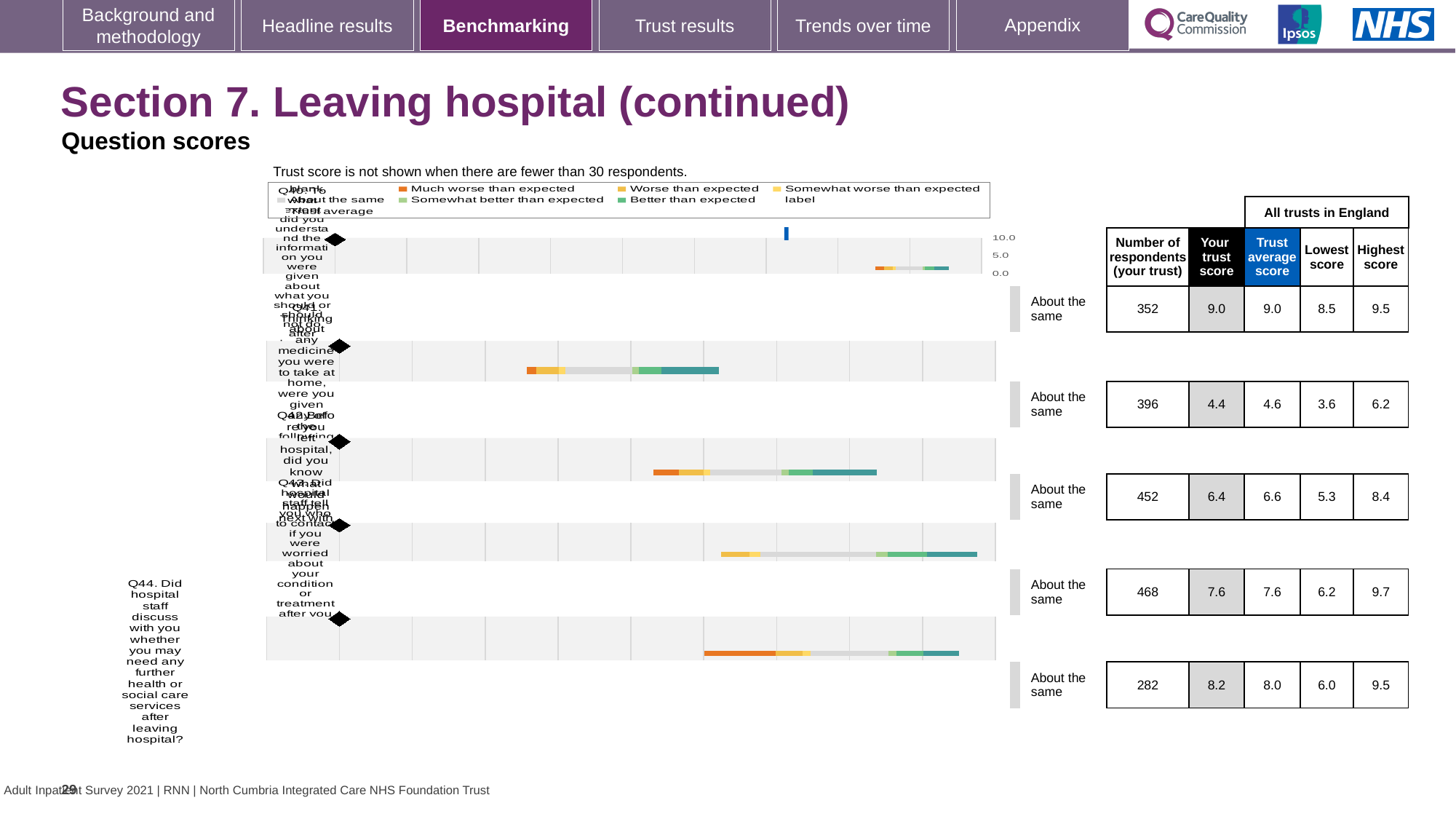
For Q44 (the bottom row), which is larger: 'Your trust score' or 'Trust average score'? Your trust score How many question rows are plotted in the chart? 5 What is the lowest 'Your trust score' value shown in the table? 4.4 What is the 'Lowest score' across all trusts in England for Q44 (the bottom row)? 6.0 What is the 'Your trust score' for Q44 (the bottom row)? 8.2 What benchmark label is shown next to Q44 (the bottom row)? About the same How many respondents are listed for Q44 (the bottom row)? 282 For Q44 (the bottom row), what is the difference between 'Your trust score' and 'Trust average score'? 0.2 What is the 'Highest score' across all trusts in England for Q44 (the bottom row)? 9.5 What is the 'Trust average score' for Q44 (the bottom row)? 8.0 What kind of chart is used to show the question scores on this slide? bar chart What is the highest 'Your trust score' value shown in the table? 9.0